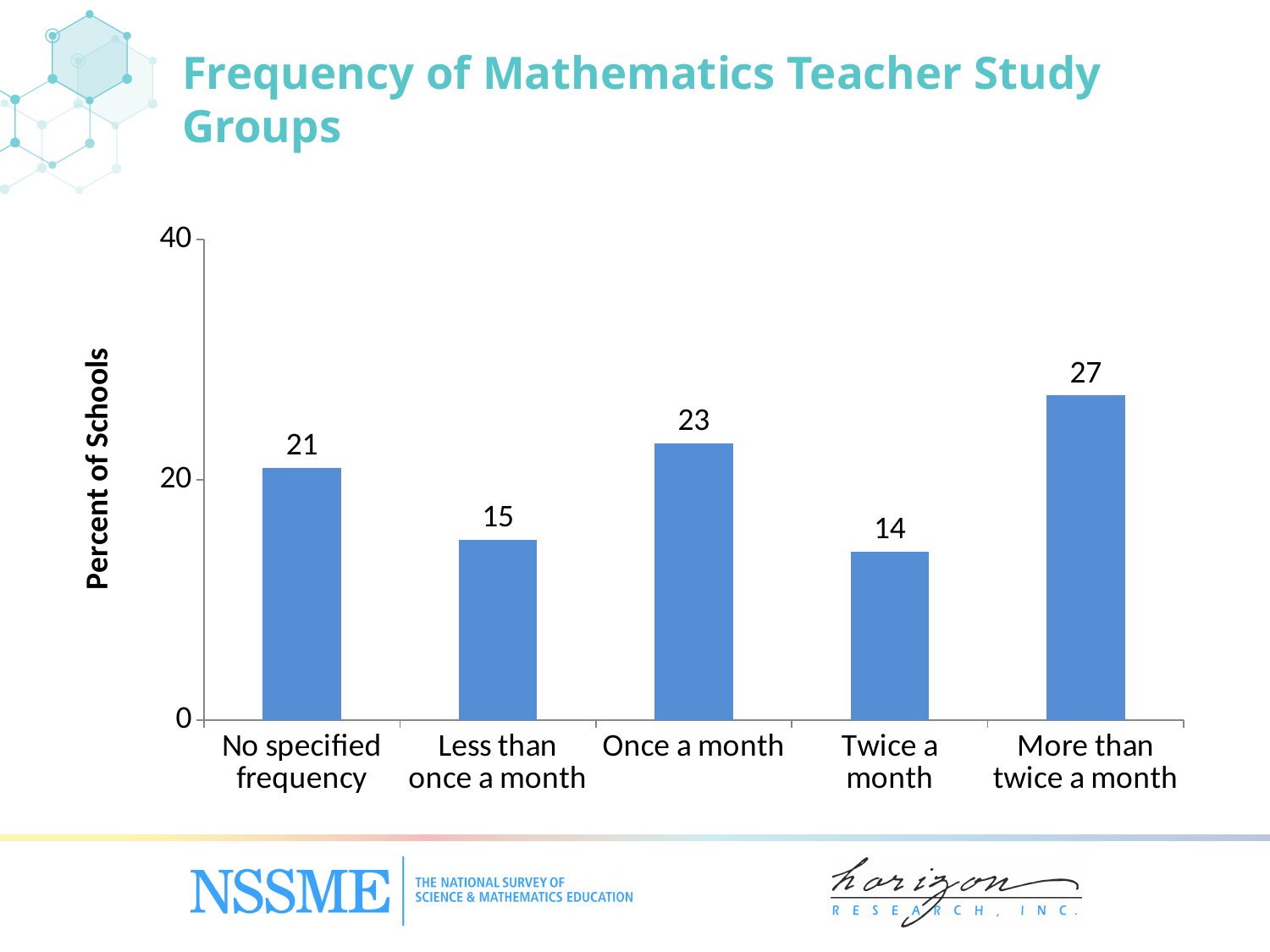
What is the difference between the values for 'More than twice a month' and 'Less than once a month'? 12 What is the value for 'Once a month'? 23 What percent of schools have mathematics teacher study groups with no specified frequency? 21 Which category has the highest percent of schools? More than twice a month What is the label of the y axis? Percent of Schools How many categories are shown on the x axis? 5 Is the value for 'More than twice a month' greater or less than 20? greater Which is larger, the value for 'Once a month' or the value for 'No specified frequency'? Once a month What is the title of the chart? Frequency of Mathematics Teacher Study Groups Which category has the lowest percent of schools? Twice a month What kind of chart is shown on the slide? Bar chart What is the value for 'Twice a month'? 14